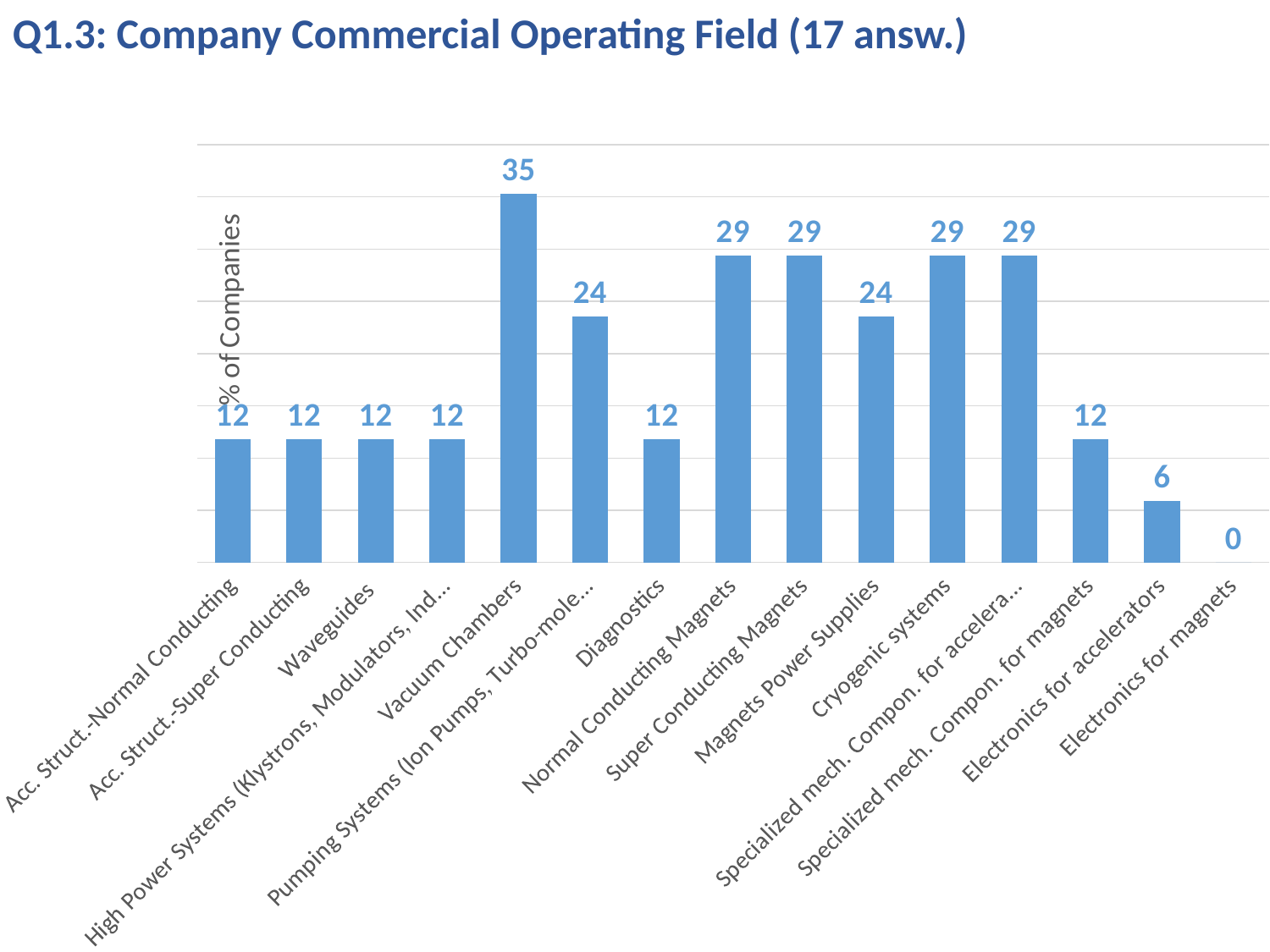
Which category has the lowest value? Electronics for magnets What is the label of the vertical axis? % of Companies What is the value for Vacuum Chambers? 35 What is the difference between the values for Vacuum Chambers and Super Conducting Magnets? 6 How many categories are shown in the chart? 15 Which is larger, the value for Waveguides or the value for Electronics for accelerators? Waveguides Which category has the highest value? Vacuum Chambers What is the value for Electronics for accelerators? 6 What is the value for Magnets Power Supplies? 24 What kind of chart is shown on the slide? Bar chart What is the value for Diagnostics? 12 What is the value for Cryogenic systems? 29